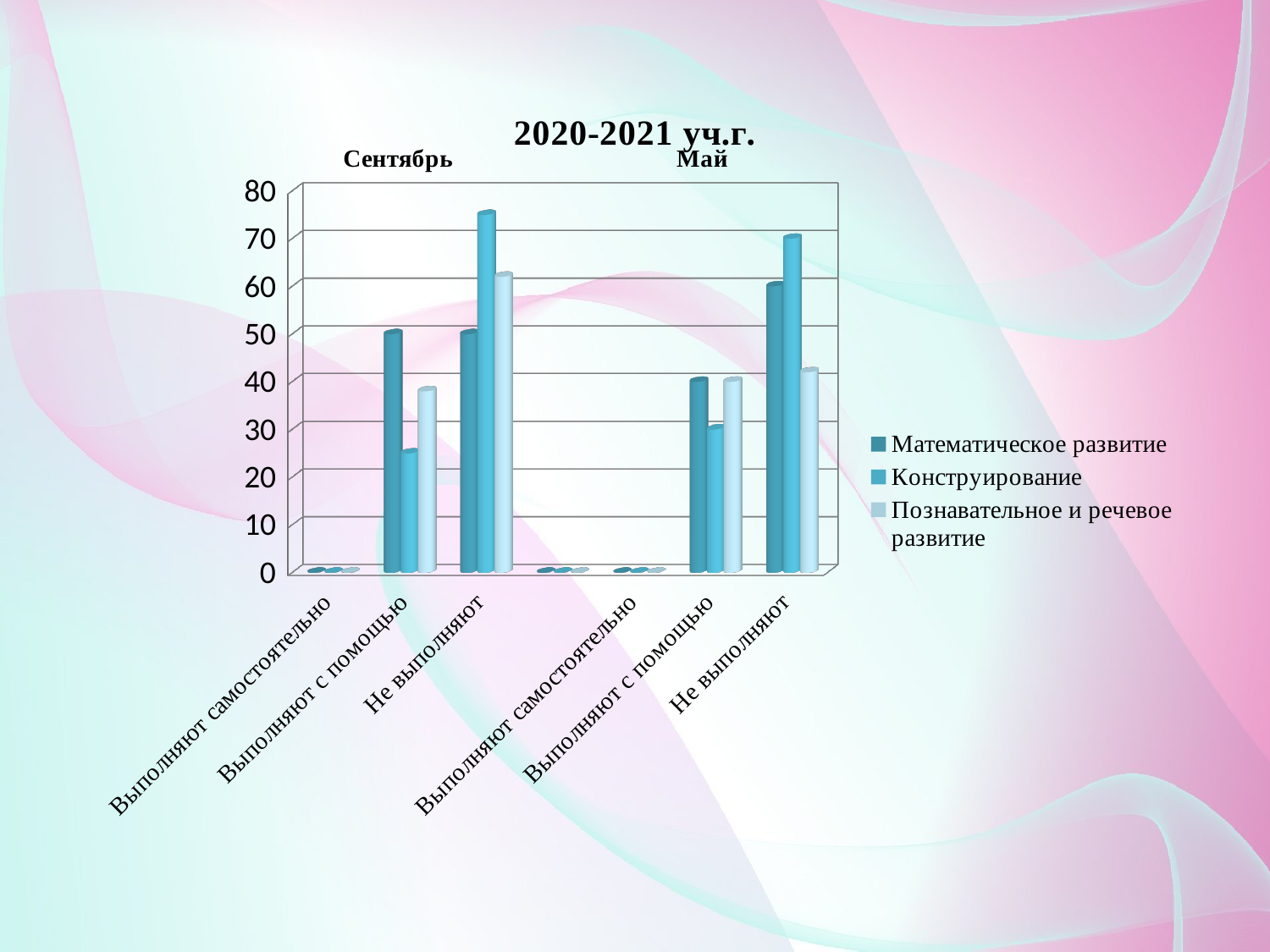
Is the value for Конструирование in the Сентябрь 'Выполняют с помощью' category greater or less than 30? less Which series has the tallest bar in the whole chart? Конструирование Is the value for Конструирование in the Сентябрь 'Не выполняют' category greater or less than 70? greater How many series does the legend list? 3 What kind of chart is shown on the slide? bar chart Is the value for Математическое развитие in the Май 'Не выполняют' category greater or less than 50? greater Which is larger in the Сентябрь 'Выполняют с помощью' category: Математическое развитие or Конструирование? Математическое развитие Which two periods are labelled above the chart? Сентябрь and Май How many categories are shown along the x axis? 6 Which is larger in the Май 'Не выполняют' category: Конструирование or Познавательное и речевое развитие? Конструирование What is the value for Математическое развитие in the Сентябрь 'Выполняют самостоятельно' category? 0 What is the title of the chart? 2020-2021 уч.г.